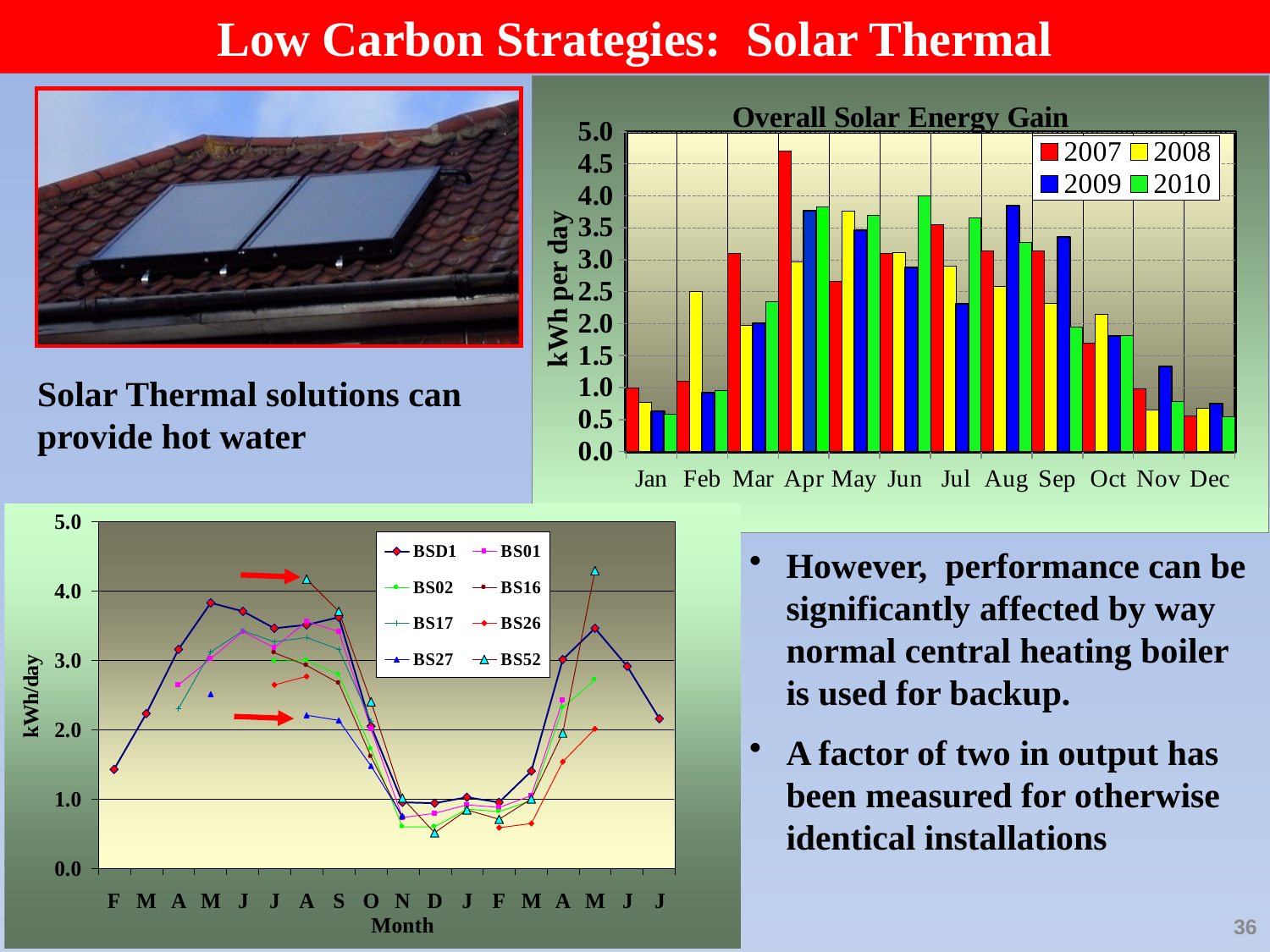
In the bottom-left chart, how many series does the legend list? 8 In the 'Overall Solar Energy Gain' chart, which is larger in Sep: 2009 or 2010? 2009 In the bottom-left chart, what kind of chart is shown? line chart In the 'Overall Solar Energy Gain' chart, what kind of chart is shown? bar chart In the 'Overall Solar Energy Gain' chart, how many months are shown on the x axis? 12 In the bottom-left chart, is the peak value for BS52 greater or less than 4.0? greater In the 'Overall Solar Energy Gain' chart, how many series does the legend list? 4 In the 'Overall Solar Energy Gain' chart, what is the y-axis label? kWh per day In the 'Overall Solar Energy Gain' chart, which year has the highest bar in Apr? 2007 In the 'Overall Solar Energy Gain' chart, is the value for 2007 in Apr greater or less than 4.0? greater In the 'Overall Solar Energy Gain' chart, is the value for 2007 in Oct greater or less than 2.0? less